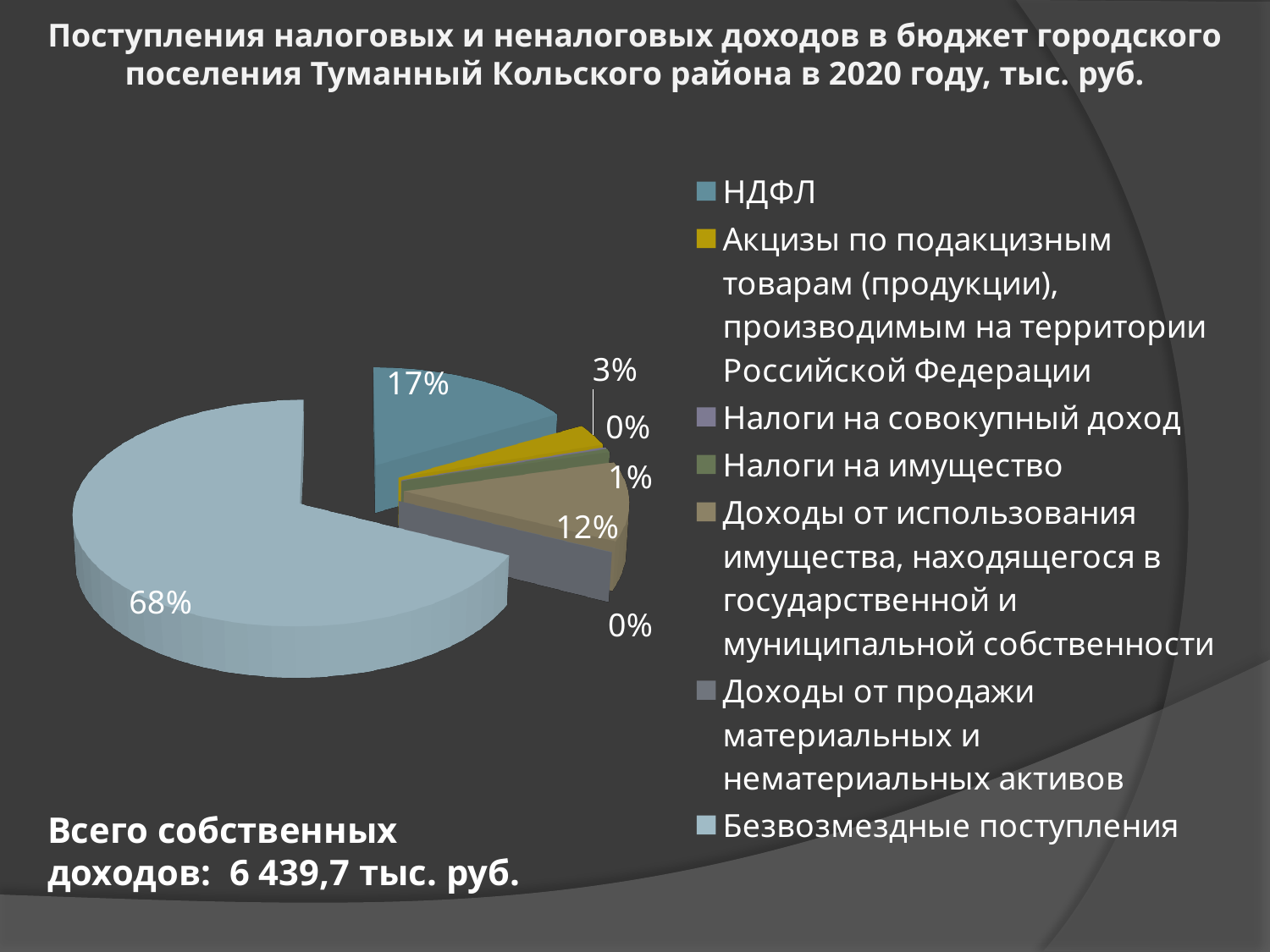
What share is labelled for Доходы от использования имущества, находящегося в государственной и муниципальной собственности? 12% What share of the pie is Налоги на имущество? 1% How many categories does the legend list? 7 By how many percentage points does Безвозмездные поступления exceed НДФЛ? 51 percentage points What total of own revenues is stated in the text below the chart? 6 439,7 тыс. руб. Which category has the largest slice of the pie? Безвозмездные поступления What percentage is shown for Безвозмездные поступления? 68% What share of the pie does НДФЛ account for? 17% Which year does the chart title refer to? 2020 Which is larger: the share for НДФЛ or the share for Доходы от использования имущества? НДФЛ What percentage is shown for Акцизы по подакцизным товарам (продукции), производимым на территории Российской Федерации? 3% What type of chart is shown on the slide? Pie chart